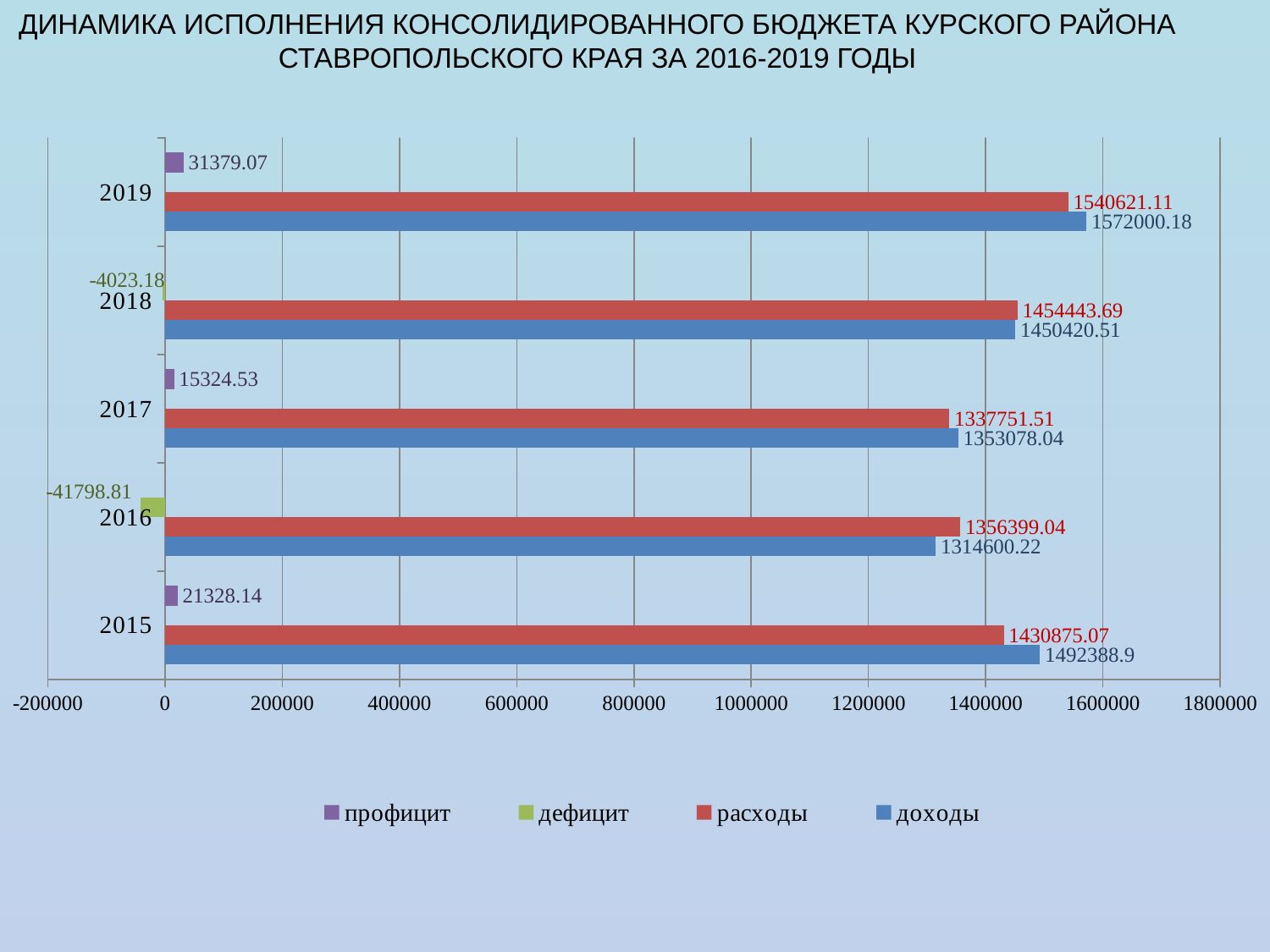
In which year is расходы the lowest? 2017 In which year is доходы the highest? 2019 What is the difference between доходы and расходы in 2019? 31379.07 What is the профицит value shown for 2015? 21328.14 How many years are shown on the chart? 5 What type of chart is shown on the slide? bar chart How many series does the legend list? 4 In 2015, which is larger: доходы or расходы? доходы What is the value of расходы for 2017? 1337751.51 What is the value of доходы for 2019? 1572000.18 What is the дефицит value shown for 2016? -41798.81 In which year is доходы the lowest? 2016